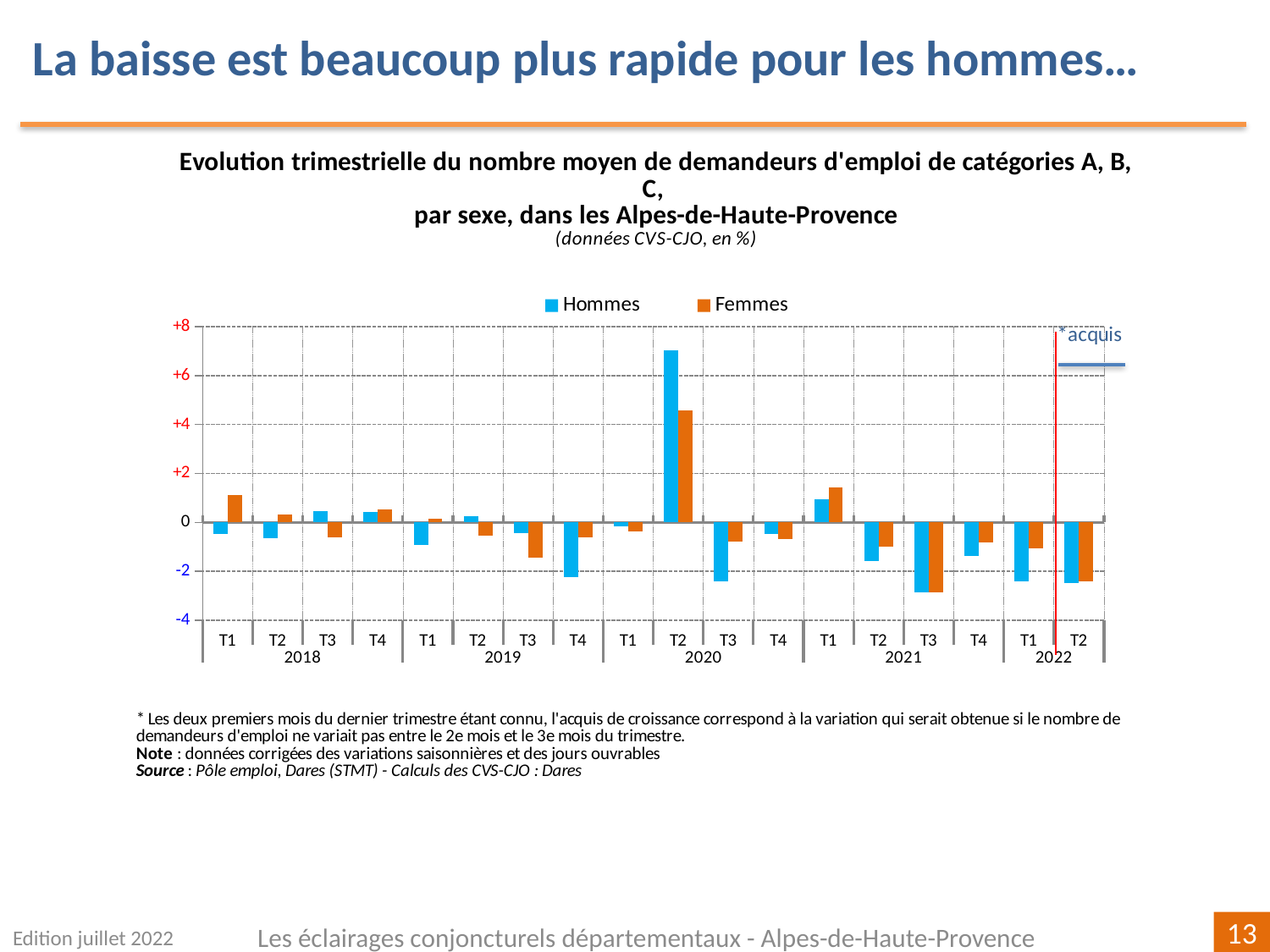
Is the value for Femmes in T2 2020 greater or less than +4? greater How many quarters are plotted along the x axis? 18 In T2 2020, which series has the larger value, Hommes or Femmes? Hommes In which quarter is the value for Femmes the highest? T2 2020 In which quarter is the value for Hommes the highest? T2 2020 How many series does the legend list? 2 Is the value for Hommes in T2 2020 greater or less than +6? greater What kind of chart is shown on the slide? Bar chart Is the value for Hommes in T3 2020 greater or less than -2? less In T1 2022, which series has the lower value, Hommes or Femmes? Hommes Which colour represents the Femmes series? Orange Which two series are shown in the legend? Hommes and Femmes